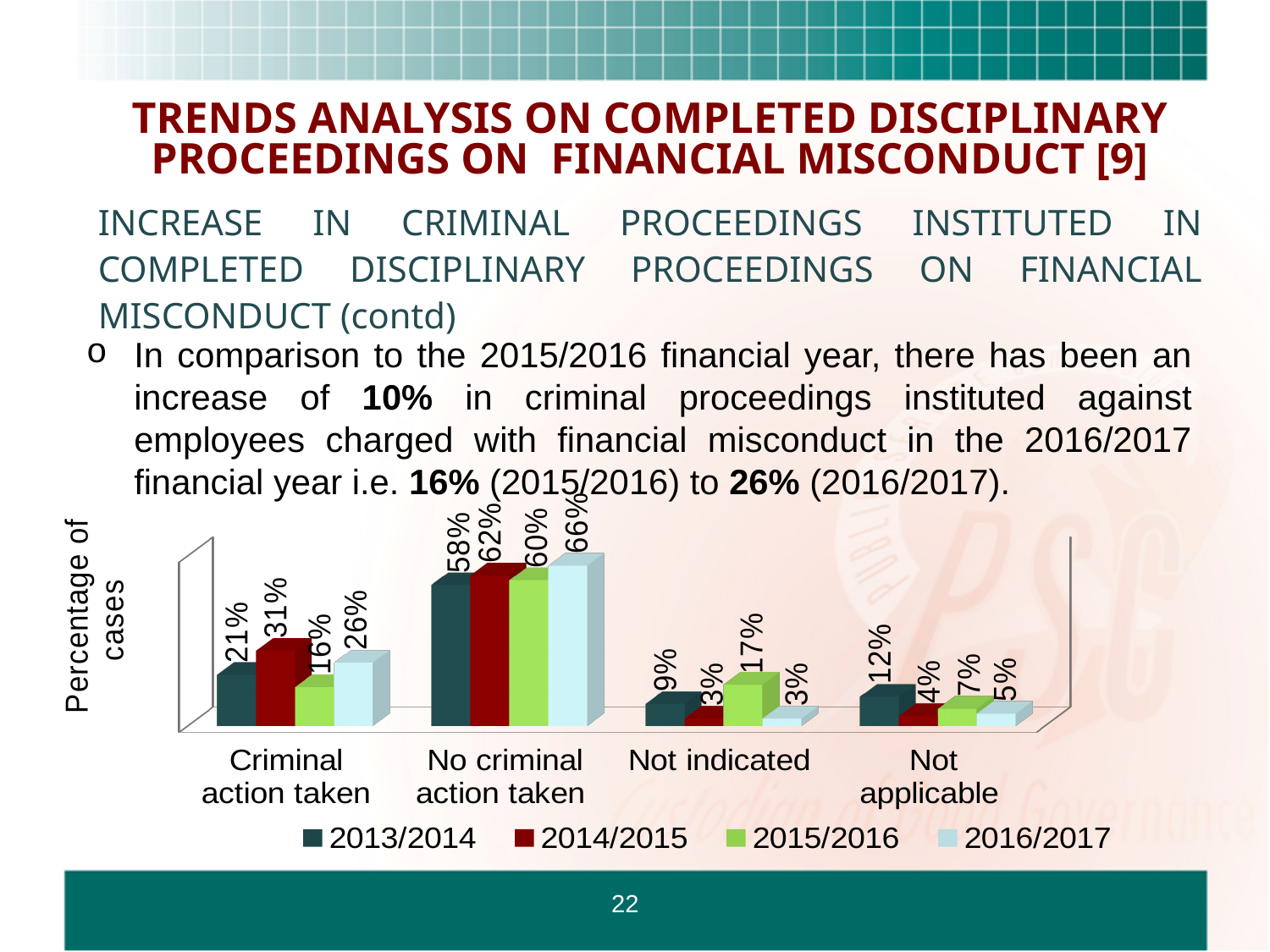
What kind of chart is shown on the slide? Bar chart Which is larger in the 'Not applicable' category: the 2015/2016 value or the 2016/2017 value? 2015/2016 What is the value for 2015/2016 in the 'Not indicated' category? 17% What is the value for 2014/2015 in the 'No criminal action taken' category? 62% What is the value for 2016/2017 in the 'Criminal action taken' category? 26% What is the label of the vertical axis? Percentage of cases What is the difference between the 2016/2017 and 2015/2016 values in the 'Criminal action taken' category? 10% How many series does the legend list? 4 Which year has the lowest value in the 'Criminal action taken' category? 2015/2016 Which year has the highest value in the 'No criminal action taken' category? 2016/2017 How many categories are shown on the x axis? 4 What is the value for 2013/2014 in the 'Not applicable' category? 12%